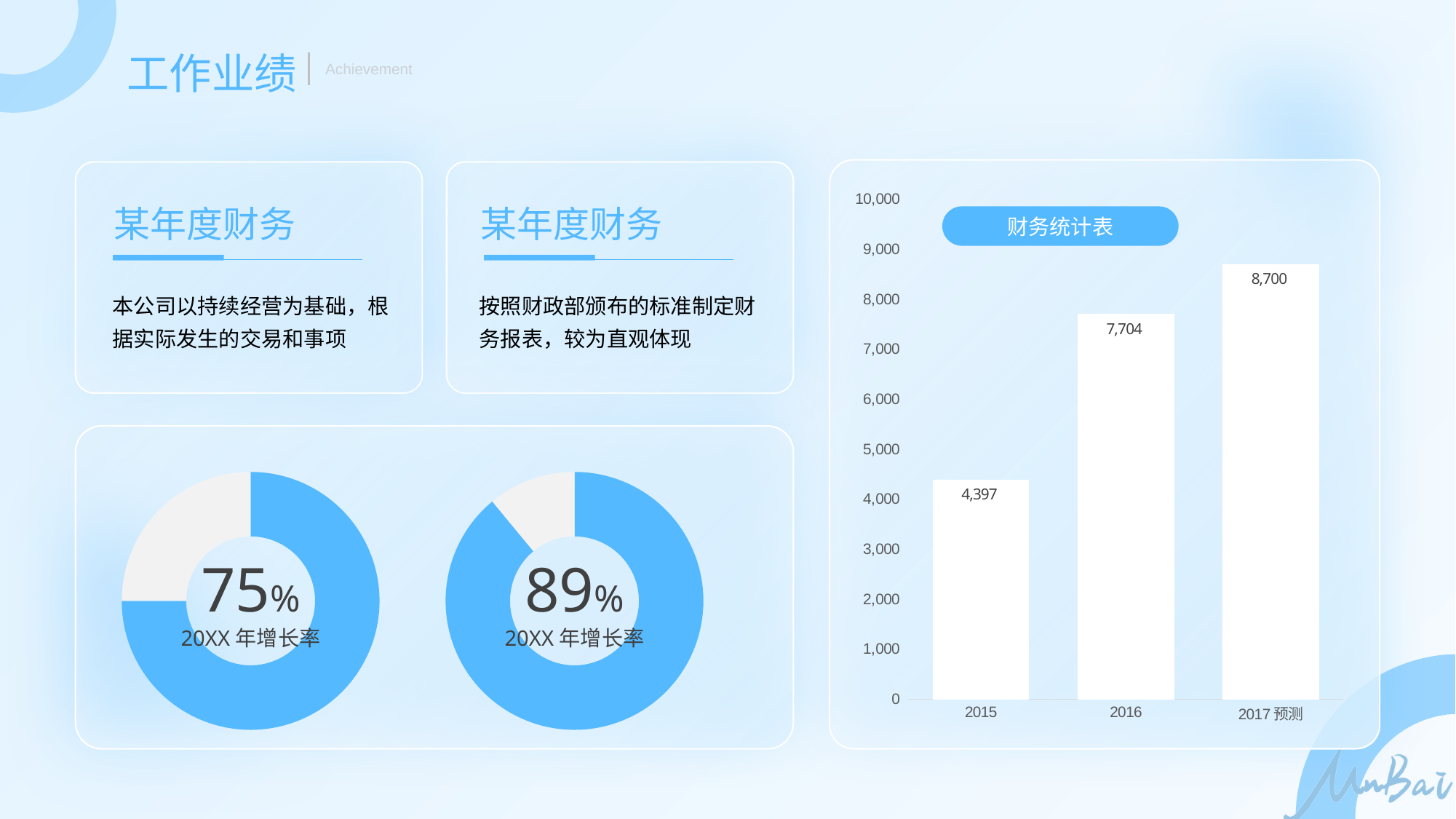
In the 财务统计表 bar chart, do the values rise or fall from 2015 to 2017 预测? rise In the 财务统计表 bar chart, what is the difference between the 2017 预测 value and the 2016 value? 996 In the 财务统计表 bar chart, what is the difference between the 2016 value and the 2015 value? 3,307 In the left donut chart at the bottom of the slide, what percentage is shown for 20XX 年增长率? 75% In the 财务统计表 bar chart, what is the value for 2017 预测? 8,700 In the 财务统计表 bar chart, which category has the highest value? 2017 预测 In the 财务统计表 bar chart, which is larger, the value for 2015 or the value for 2016? 2016 In the 财务统计表 bar chart, what is the value for 2015? 4,397 In the 财务统计表 bar chart, which category has the lowest value? 2015 What kind of chart is the 财务统计表 chart on the right of the slide? bar chart In the 财务统计表 bar chart, how many categories are shown on the x axis? 3 In the 财务统计表 bar chart, what is the value for 2016? 7,704